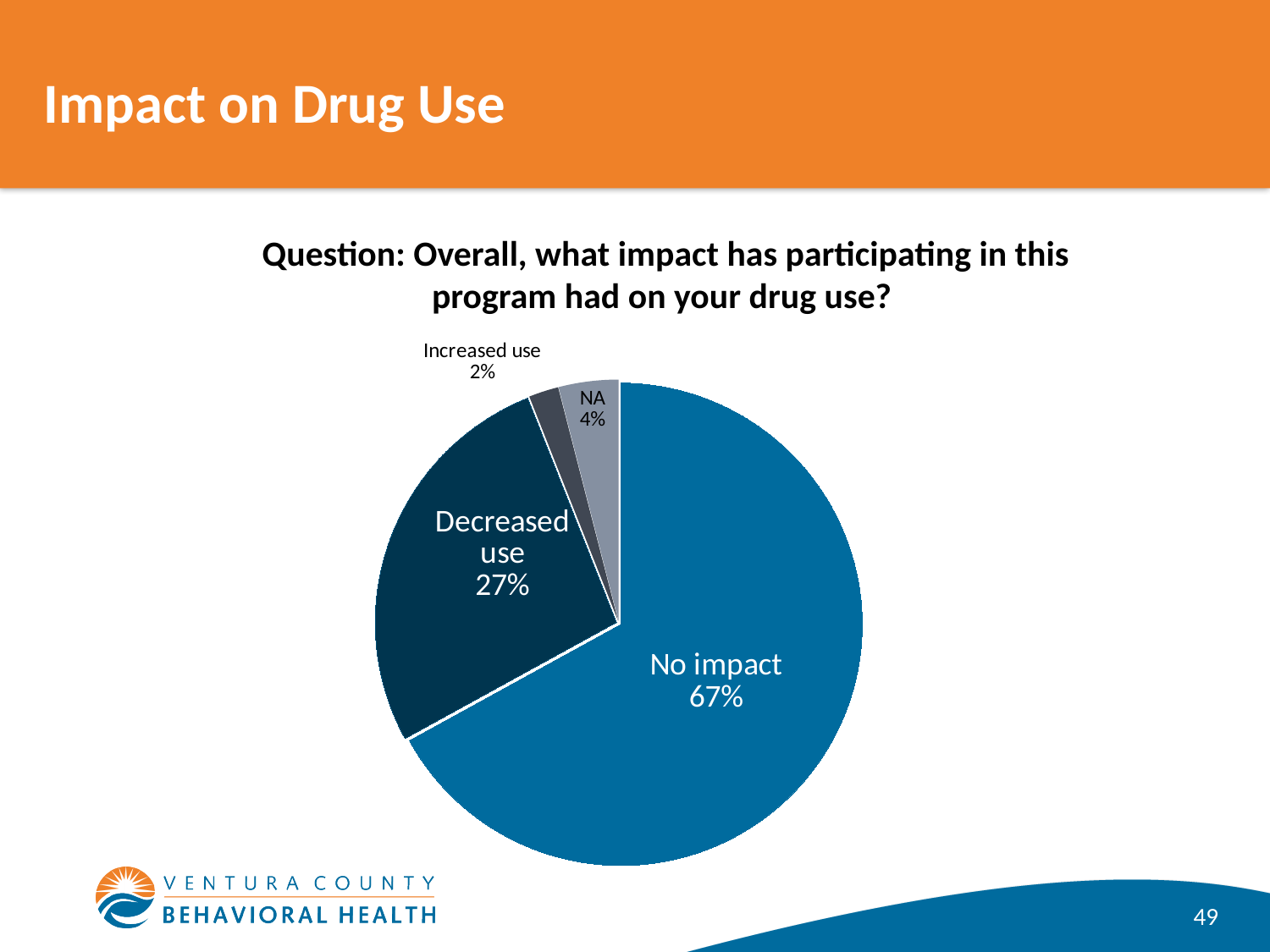
Which response category has the largest share of the pie? No impact What percentage of respondents reported no impact on their drug use? 67% Which is larger, the share for Decreased use or the share for NA? Decreased use What percentage of respondents reported decreased use? 27% What is the difference in percentage points between No impact and Decreased use? 40 What kind of chart is shown on the slide? Pie chart What percentage of responses are labelled NA? 4% What survey question does the chart title say the chart is based on? Overall, what impact has participating in this program had on your drug use? What is the combined share of Decreased use and Increased use? 29% Which response category has the smallest share of the pie? Increased use What percentage of respondents reported increased use? 2% How many slices does the pie chart have? 4